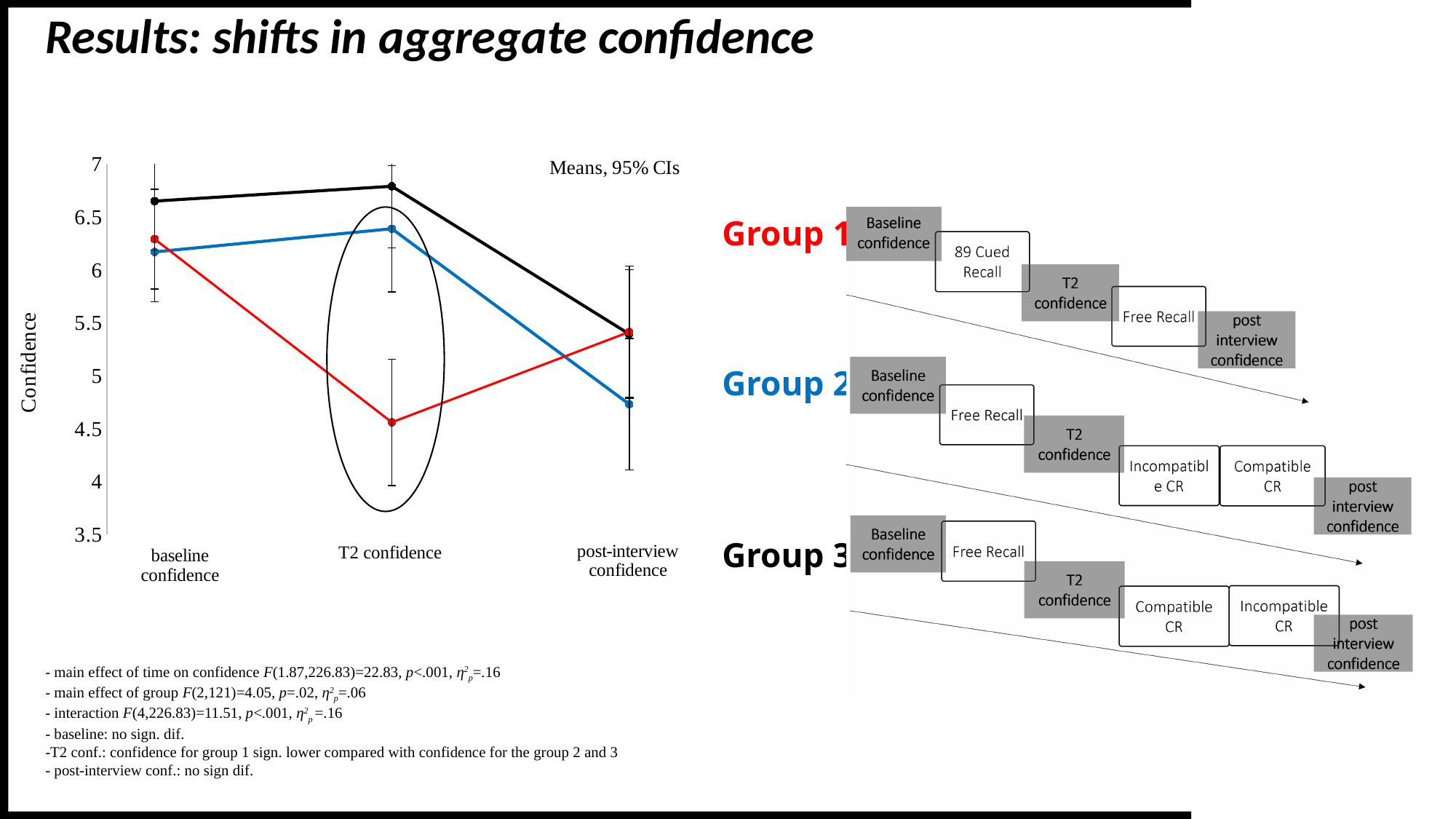
Is the blue line's value at post-interview confidence greater or less than 5? less What is the title of the y axis on the confidence chart? Confidence At baseline confidence, which is higher: the black line or the red line? the black line Is the black line's value at baseline confidence greater or less than 6.5? greater Does the red line rise or fall from baseline confidence to T2 confidence? fall Which line has the highest value at T2 confidence? the black line How many points are plotted along the x axis of the confidence chart? 3 What kind of chart is shown on the left of the slide? line chart Is the red line's value at T2 confidence greater or less than 5? less Which line has the lowest value at T2 confidence? the red line What annotation appears in the top right of the confidence chart? Means, 95% CIs